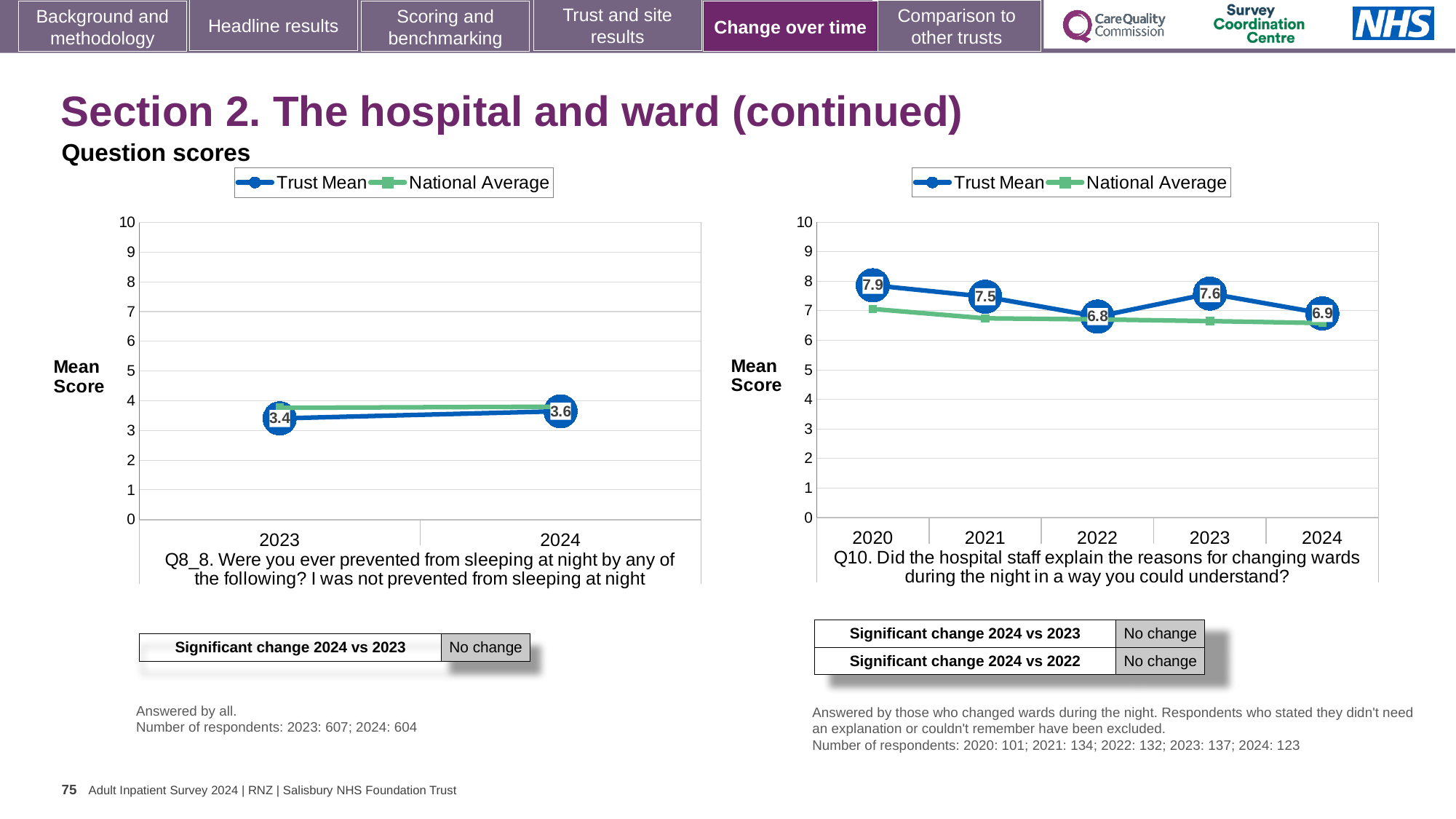
In the Q10 chart on the right, what is the difference between the Trust Mean in 2020 and in 2024? 1.0 In the Q8_8 chart on the left, what is the Trust Mean score for 2023? 3.4 In the Q10 chart on the right, what is the Trust Mean score for 2020? 7.9 In the Q10 chart on the right, is the Trust Mean for 2023 higher or lower than the Trust Mean for 2024? higher In the Q10 chart on the right, which year has the lowest Trust Mean score? 2022 In the Q8_8 chart on the left, what is the Trust Mean score for 2024? 3.6 In the Q10 chart on the right, what is the Trust Mean score for 2022? 6.8 In the Q8_8 chart on the left, how many years are shown on the x axis? 2 In the Q10 chart on the right, which year has the highest Trust Mean score? 2020 In the Q8_8 chart on the left, by how much did the Trust Mean change from 2023 to 2024? 0.2 In the Q10 chart on the right, is the National Average for 2024 greater or less than 7? less How many series does the legend of the Q10 chart on the right list? 2